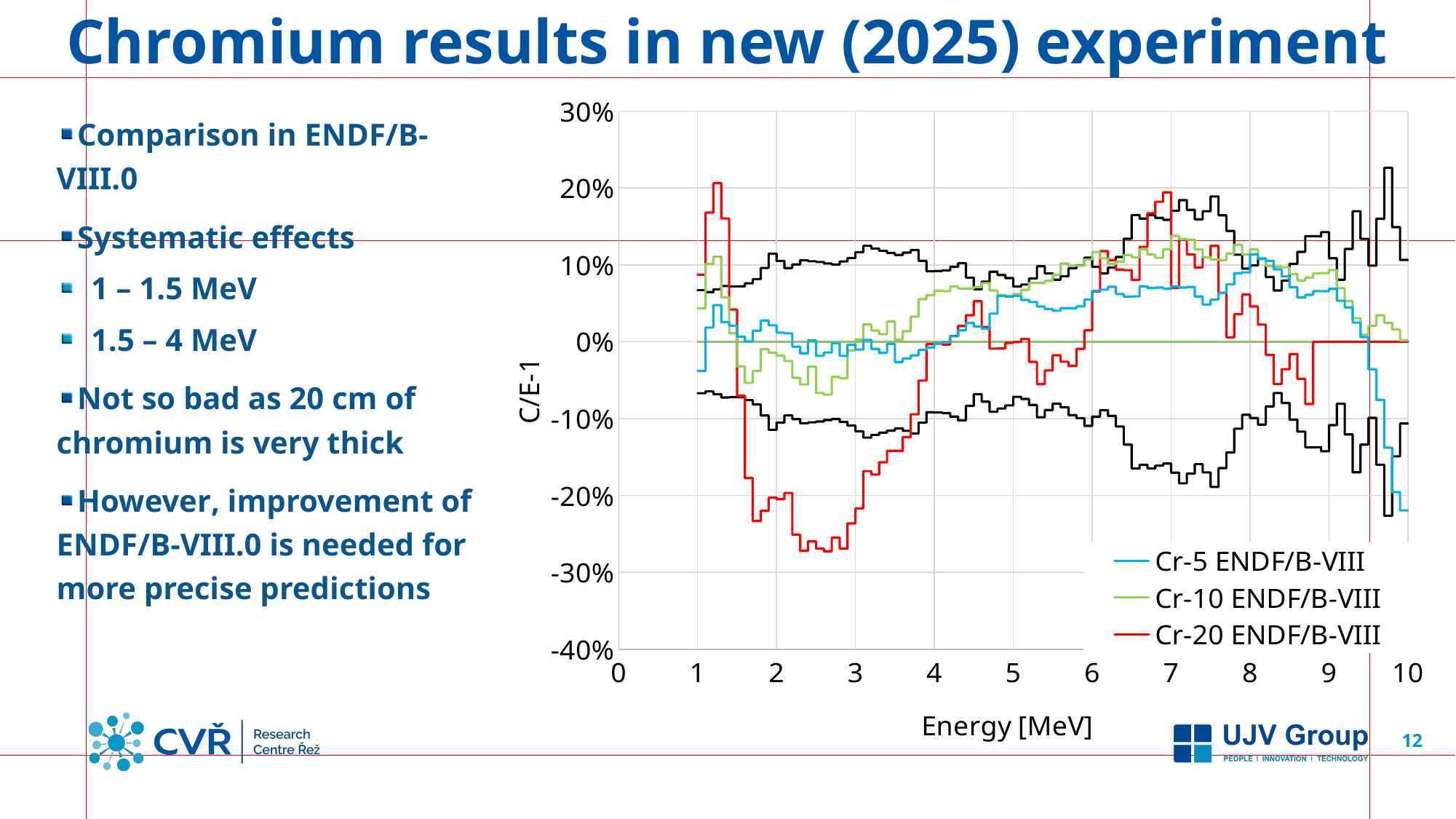
At about 2.5 MeV, which series has the higher value, Cr-10 ENDF/B-VIII or Cr-20 ENDF/B-VIII? Cr-10 ENDF/B-VIII Is the value of the Cr-10 ENDF/B-VIII series at about 2.5 MeV greater or less than -10%? greater What colour is the Cr-20 ENDF/B-VIII line in the chart? red Which legend series reaches the lowest value anywhere on the chart? Cr-20 ENDF/B-VIII What is the label of the vertical axis of the chart? C/E-1 Is the value of the Cr-20 ENDF/B-VIII series at about 2.5 MeV greater or less than -20%? less Is the value of the Cr-20 ENDF/B-VIII series at about 1.2 MeV greater or less than 10%? greater How many series does the chart legend list? 3 What kind of chart is shown on the slide? line chart